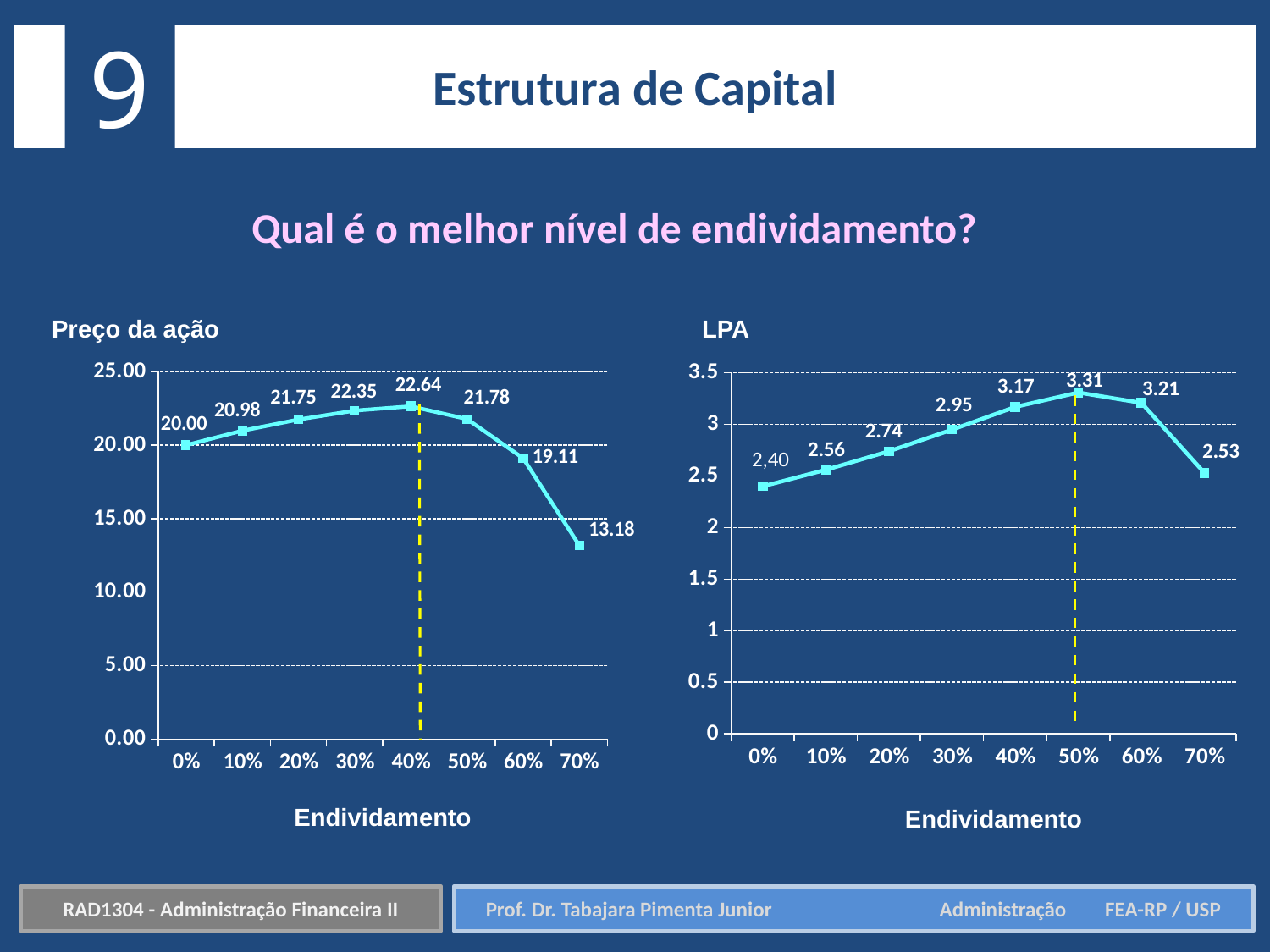
In the 'LPA' chart, at which Endividamento level is LPA highest? 50% In the 'Preço da ação' chart, what is the difference between the values at 40% and 70% Endividamento? 9.46 In the 'LPA' chart, what is the value at 50% Endividamento? 3.31 In the 'Preço da ação' chart, what is the value at 70% Endividamento? 13.18 In the 'LPA' chart, which is larger: the value at 60% or the value at 70% Endividamento? 60% In the 'LPA' chart, what is the difference between the values at 50% and 40% Endividamento? 0.14 What type of chart is the 'LPA' chart? Line chart How many Endividamento levels are plotted in the 'Preço da ação' chart? 8 In the 'Preço da ação' chart, at which Endividamento level is the share price highest? 40% In the 'Preço da ação' chart, at which Endividamento level is the share price lowest? 70% In the 'Preço da ação' chart, what is the value at 40% Endividamento? 22.64 In the 'LPA' chart, what is the value at 0% Endividamento? 2,40